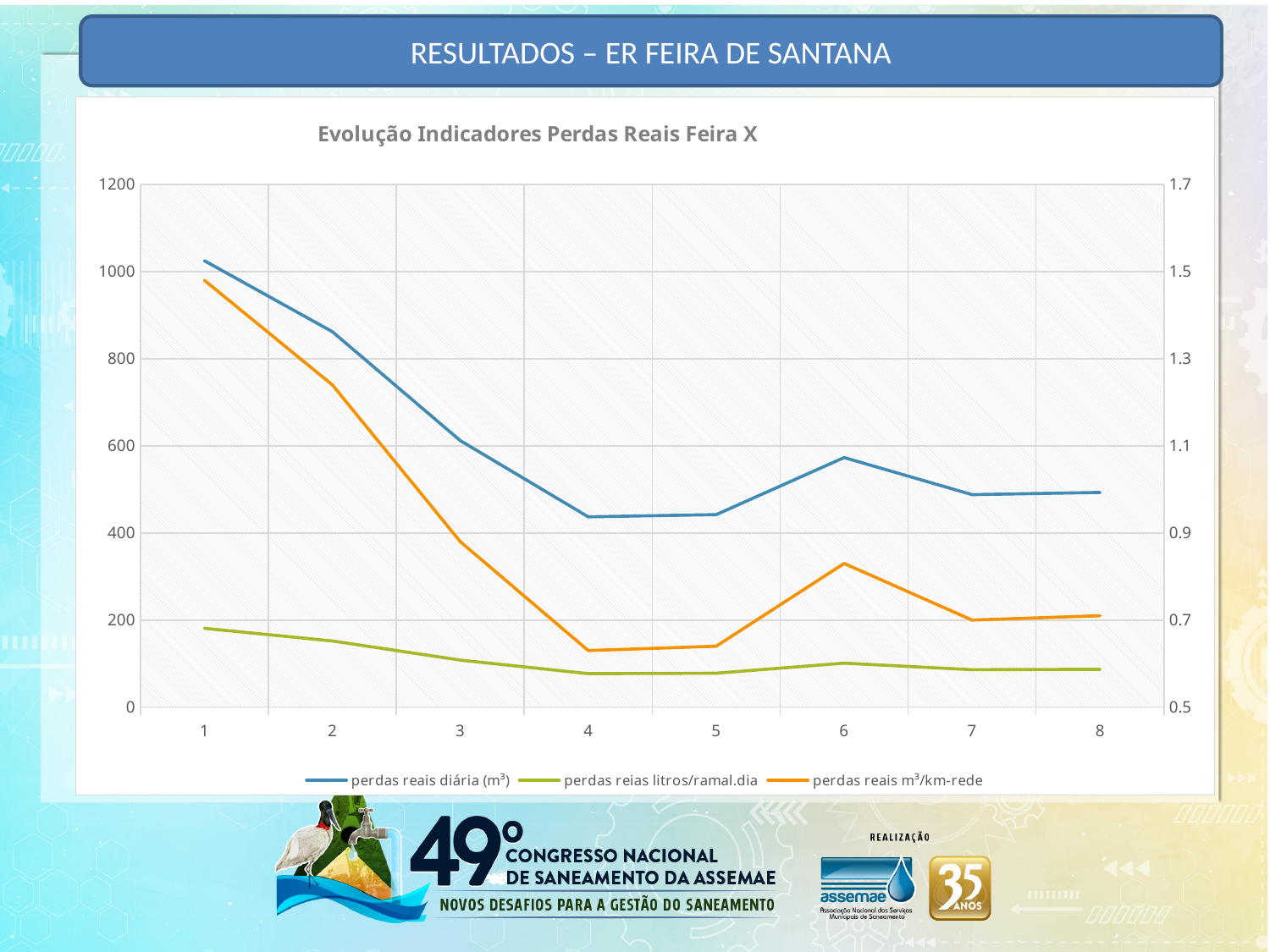
How many points are plotted along the x axis for each series? 8 Read against the left axis, is the value of 'perdas reais diária (m³)' at point 4 greater or less than 600? less How many series does the legend list? 3 At which x-axis point is the series 'perdas reias litros/ramal.dia' highest? 1 What is the title of the chart? Evolução Indicadores Perdas Reais Feira X Does the series 'perdas reais diária (m³)' rise or fall from point 1 to point 4? fall At which x-axis point is the series 'perdas reais diária (m³)' highest? 1 For the series 'perdas reais m³/km-rede', is the value at point 6 or at point 7 larger? point 6 Read against the left axis, is the value of 'perdas reais diária (m³)' at point 1 greater or less than 1000? greater For the series 'perdas reais diária (m³)', is the value at point 1 or at point 8 larger? point 1 Which colour is used for the series 'perdas reais m³/km-rede'? orange What kind of chart is shown on the slide? line chart